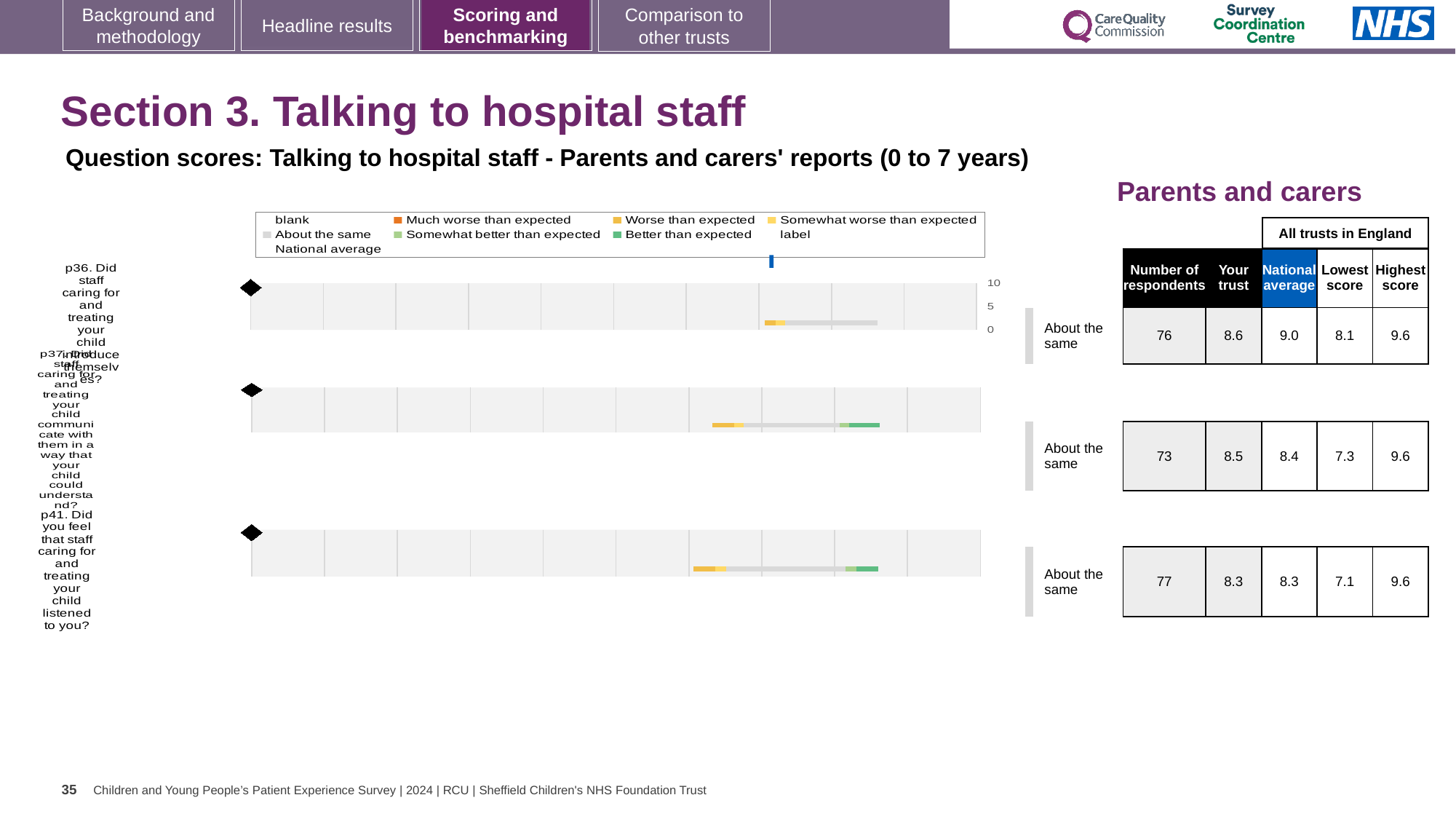
What is the highest tick value shown on the chart's score axis? 10 In the table beside the chart, what is the 'Your trust' score for the first row (p36)? 8.6 How many survey questions (categories) are plotted in the chart? 3 In the table beside the chart, what is the Lowest score for the third row (p41)? 7.1 What colour does the legend use for 'Better than expected'? green In the table beside the chart, what is the Highest score for the first row (p36)? 9.6 In the table beside the chart, what is the National average for the second row (p37)? 8.4 In the table beside the chart, how many respondents are listed for the third row (p41)? 77 What kind of chart is shown on the slide? bar chart According to the table, what is the difference between the National average and the 'Your trust' score for the first row (p36)? 0.4 According to the table, which row has the highest 'Your trust' score? p36 (first row), 8.6 According to the table, for the second row (p37), which is larger: the 'Your trust' score or the National average? Your trust (8.5)